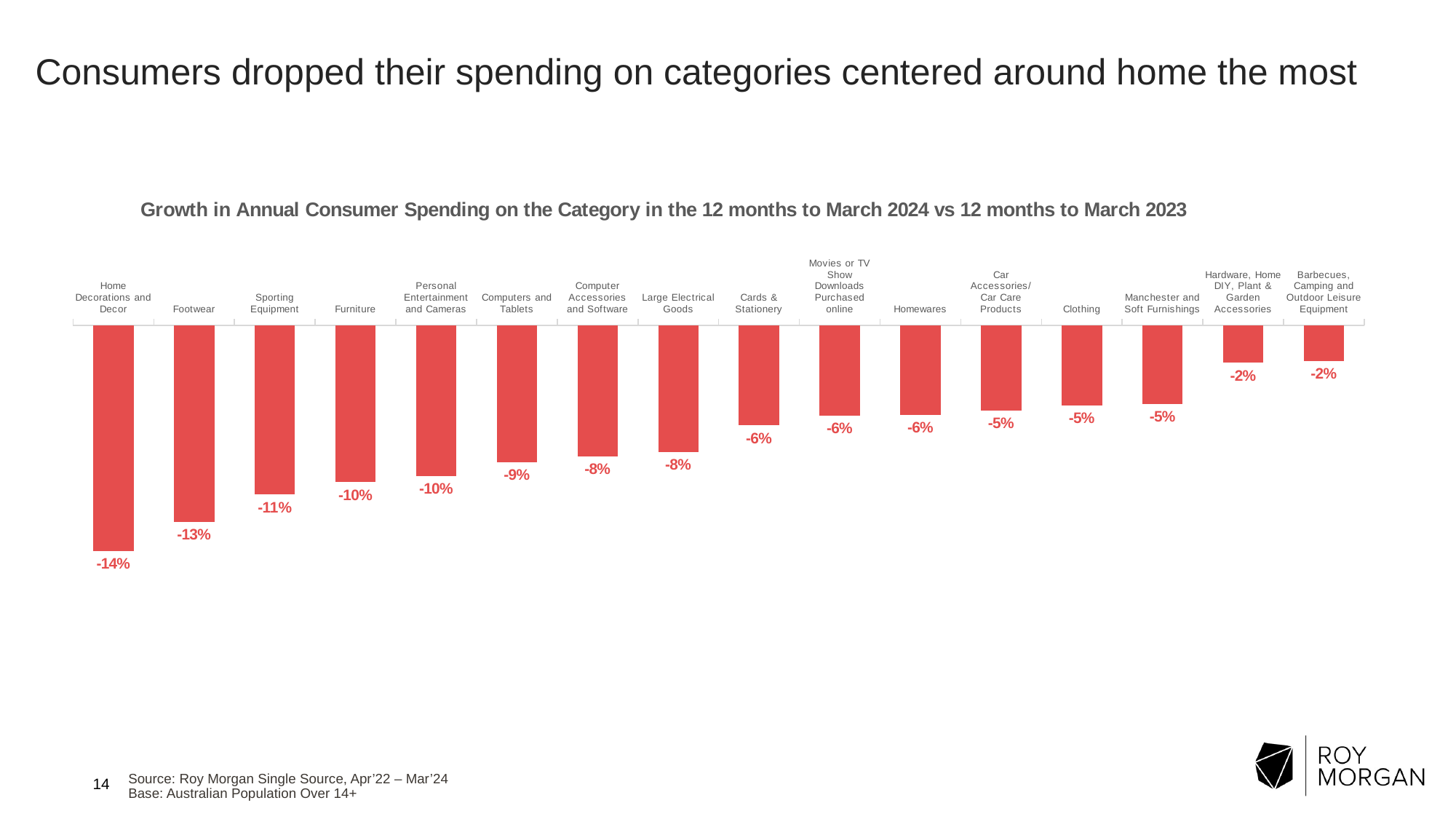
Which category shows the largest decline in spending? Home Decorations and Decor How many categories are plotted in the chart? 16 What is the value for Homewares? -6% What value is shown for Footwear? -13% What type of chart is shown on the slide? Bar chart What is the value shown for Clothing? -5% What is the title of the chart? Growth in Annual Consumer Spending on the Category in the 12 months to March 2024 vs 12 months to March 2023 Which shows a larger decline, Sporting Equipment or Large Electrical Goods? Sporting Equipment What is the growth in annual consumer spending for Home Decorations and Decor? -14% What is the difference in percentage points between the values for Footwear and Clothing? 8 percentage points What colour are the bars in the chart? Red What is the value for Computers and Tablets? -9%